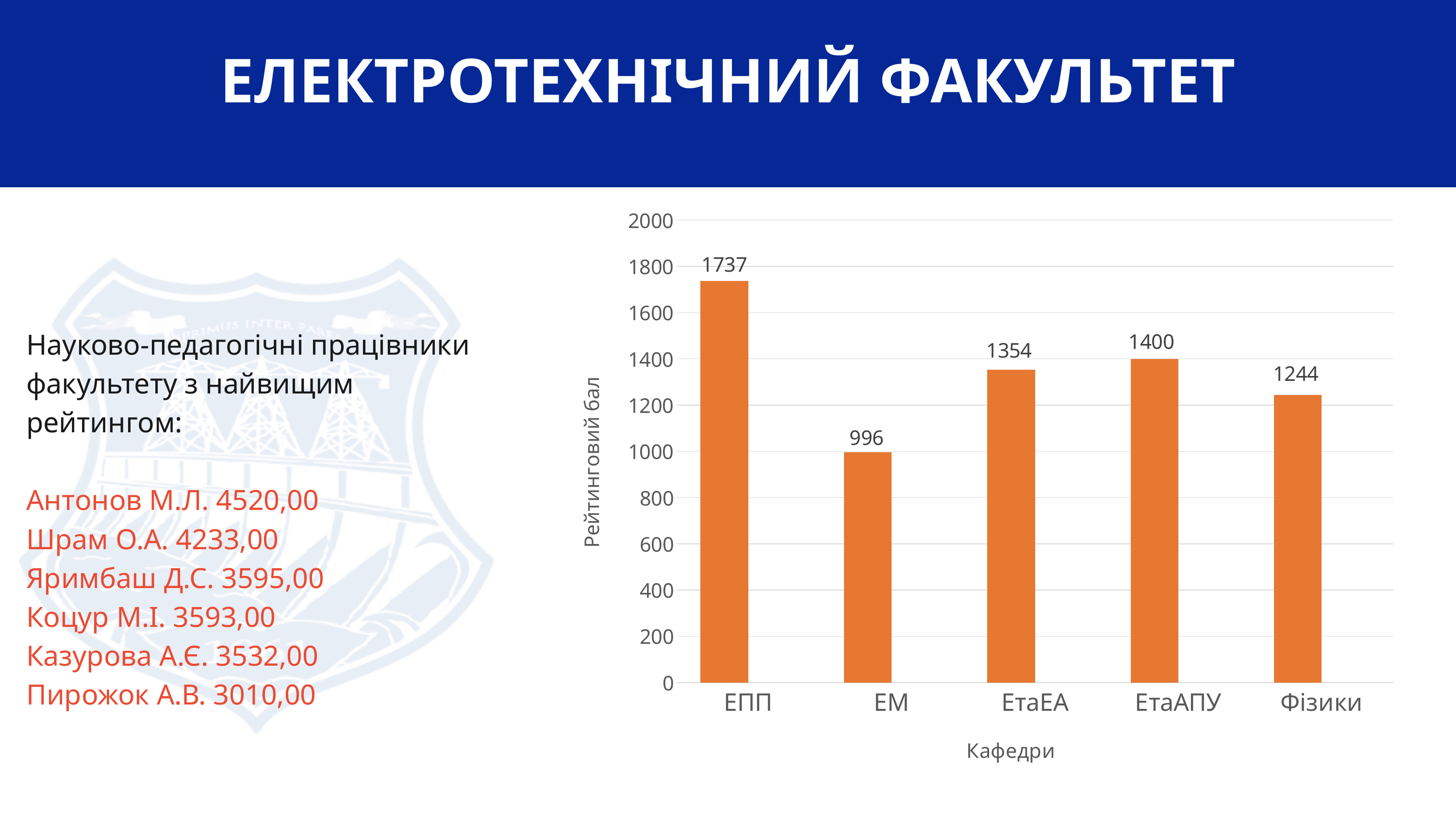
Which department (кафедра) has the highest rating score? ЕПП What is the rating score (Рейтинговий бал) for ЕПП? 1737 Which has a higher rating score, ЕтаАПУ or Фізики? ЕтаАПУ Is the value for ЕтаЕА greater or less than 1200? greater What is the difference between the rating scores of ЕПП and ЕМ? 741 What is the difference between the rating scores of ЕтаАПУ and ЕтаЕА? 46 What is the rating score for ЕМ? 996 How many departments are shown on the x axis of the chart? 5 What is the rating score for Фізики? 1244 What is the rating score for ЕтаЕА? 1354 Which department has the lowest rating score? ЕМ What kind of chart is shown on the slide? bar chart